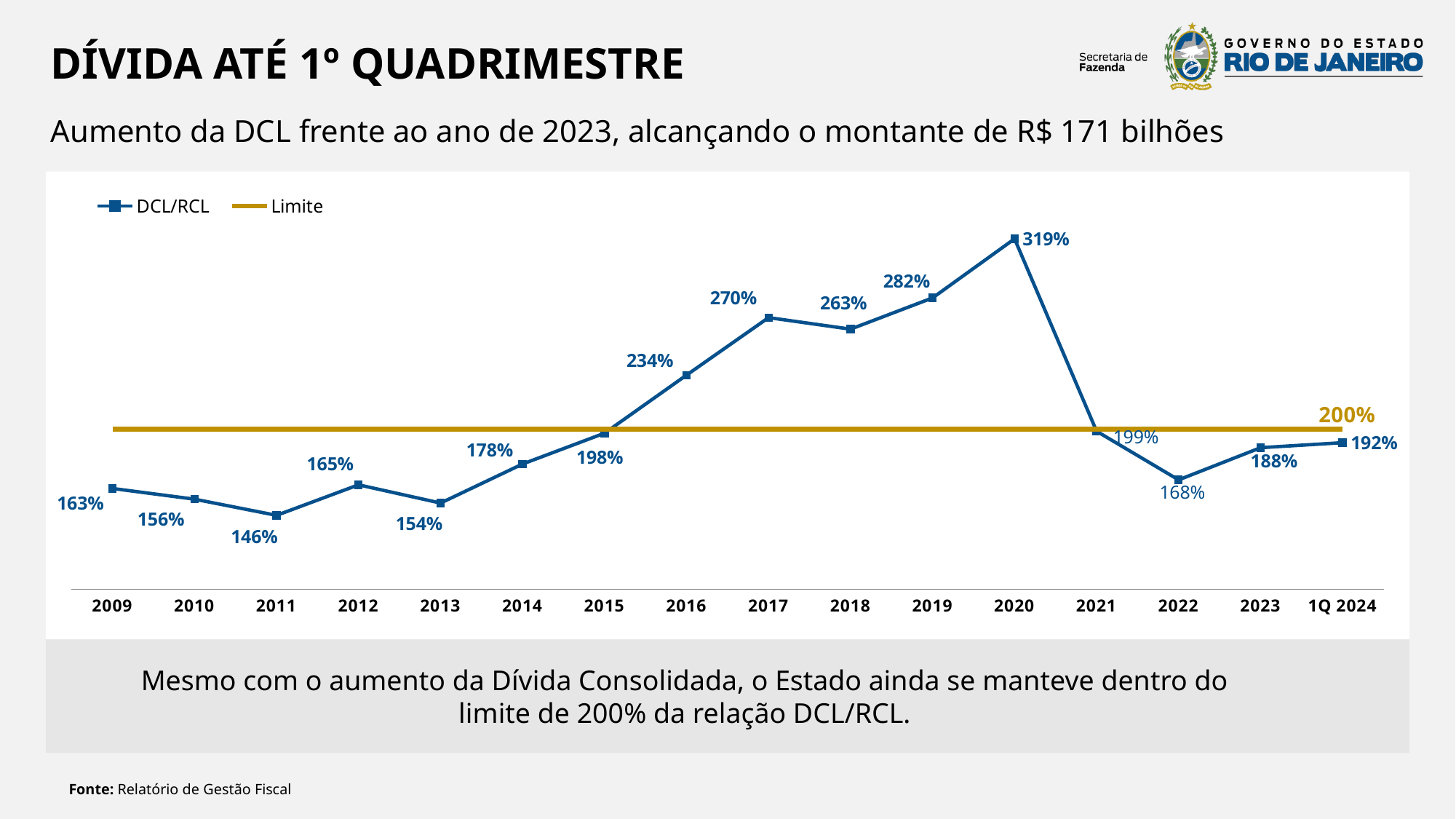
Which year has the highest DCL/RCL value? 2020 What is the DCL/RCL value for 2020? 319% Which is larger, the DCL/RCL value for 2017 or for 2018? 2017 Which year has the lowest DCL/RCL value? 2011 How many data points does the DCL/RCL series have? 16 What value does the Limite line represent? 200% What is the DCL/RCL value for 2015? 198% What is the DCL/RCL value for 1Q 2024? 192% What kind of chart is shown on the slide? Line chart How many series does the legend list? 2 What is the difference between the DCL/RCL values for 2020 and 2021? 120% What is the DCL/RCL value for 2011? 146%